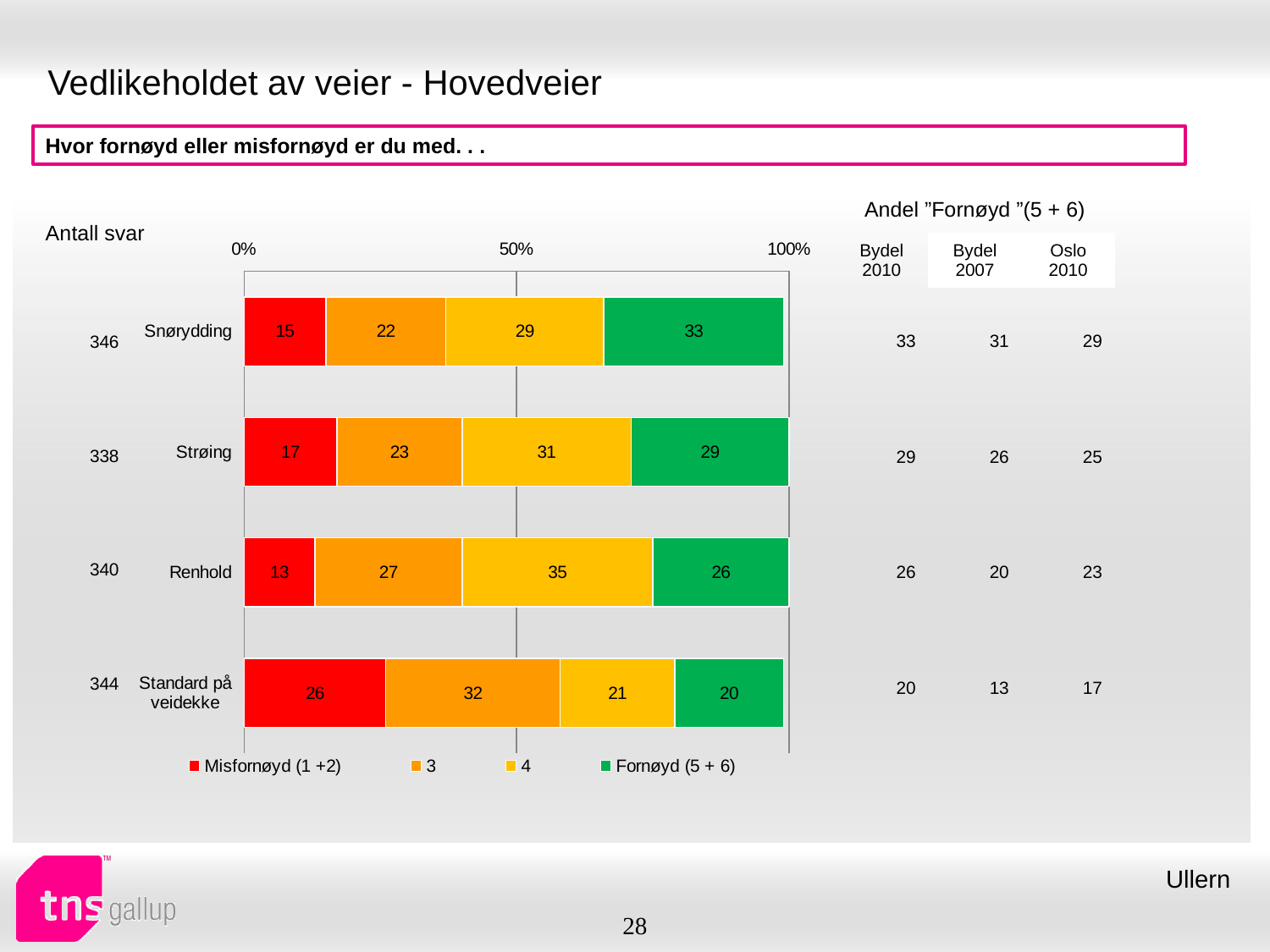
What kind of chart is shown on the slide? stacked bar chart How many series does the chart legend list? 4 What is the value of the Misfornøyd (1 +2) series for Standard på veidekke? 26 How many categories are plotted in the chart? 4 What is the value of the Fornøyd (5 + 6) series for Snørydding? 33 Which category has the lowest value for the Misfornøyd (1 +2) series? Renhold What is the value of series 3 for Strøing? 23 Which is larger: the series 4 value for Strøing or the series 4 value for Standard på veidekke? Strøing Which category has the highest value for the Fornøyd (5 + 6) series? Snørydding Which series in the legend is shown in green? Fornøyd (5 + 6) What is the difference between the Fornøyd (5 + 6) values for Snørydding and Standard på veidekke? 13 What is the value of series 4 for Renhold? 35